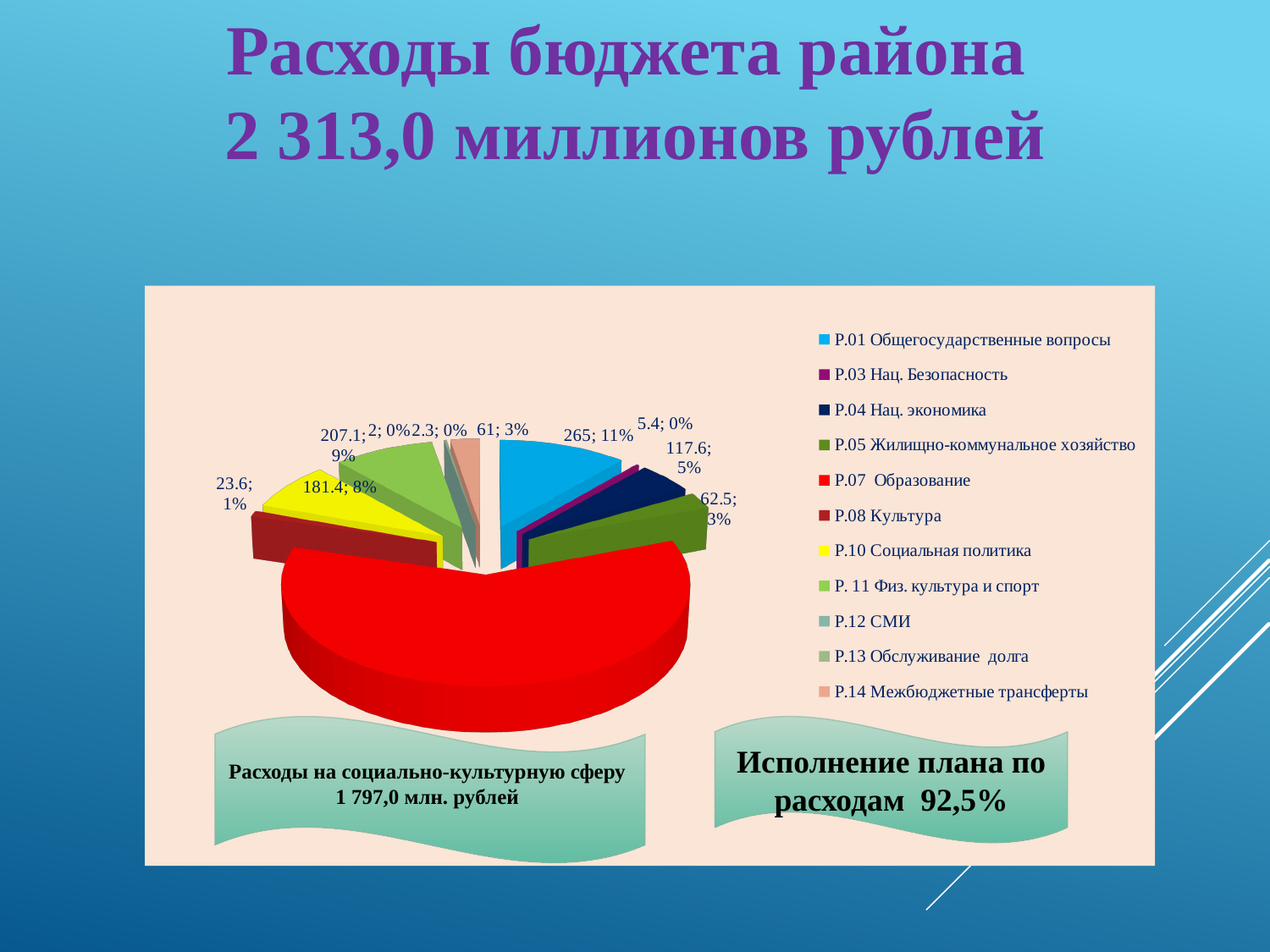
What value is shown for Р.10 Социальная политика? 181.4 What share of the pie does Р.05 Жилищно-коммунальное хозяйство take? 3% What value is shown for Р.14 Межбюджетные трансферты? 61 What is the difference between the values for Р.01 Общегосударственные вопросы and Р.04 Нац. экономика? 147.4 Which is larger, the value for Р.01 Общегосударственные вопросы or for Р.04 Нац. экономика? Р.01 Общегосударственные вопросы What kind of chart is shown on the slide? pie chart What value is shown for Р.01 Общегосударственные вопросы? 265 What is the title of the slide above the chart? Расходы бюджета района 2 313,0 миллионов рублей What share of the pie does Р.01 Общегосударственные вопросы take? 11% Which category has the largest slice of the pie? Р.07 Образование How many categories does the legend of the pie chart list? 11 What value is shown for Р.04 Нац. экономика? 117.6